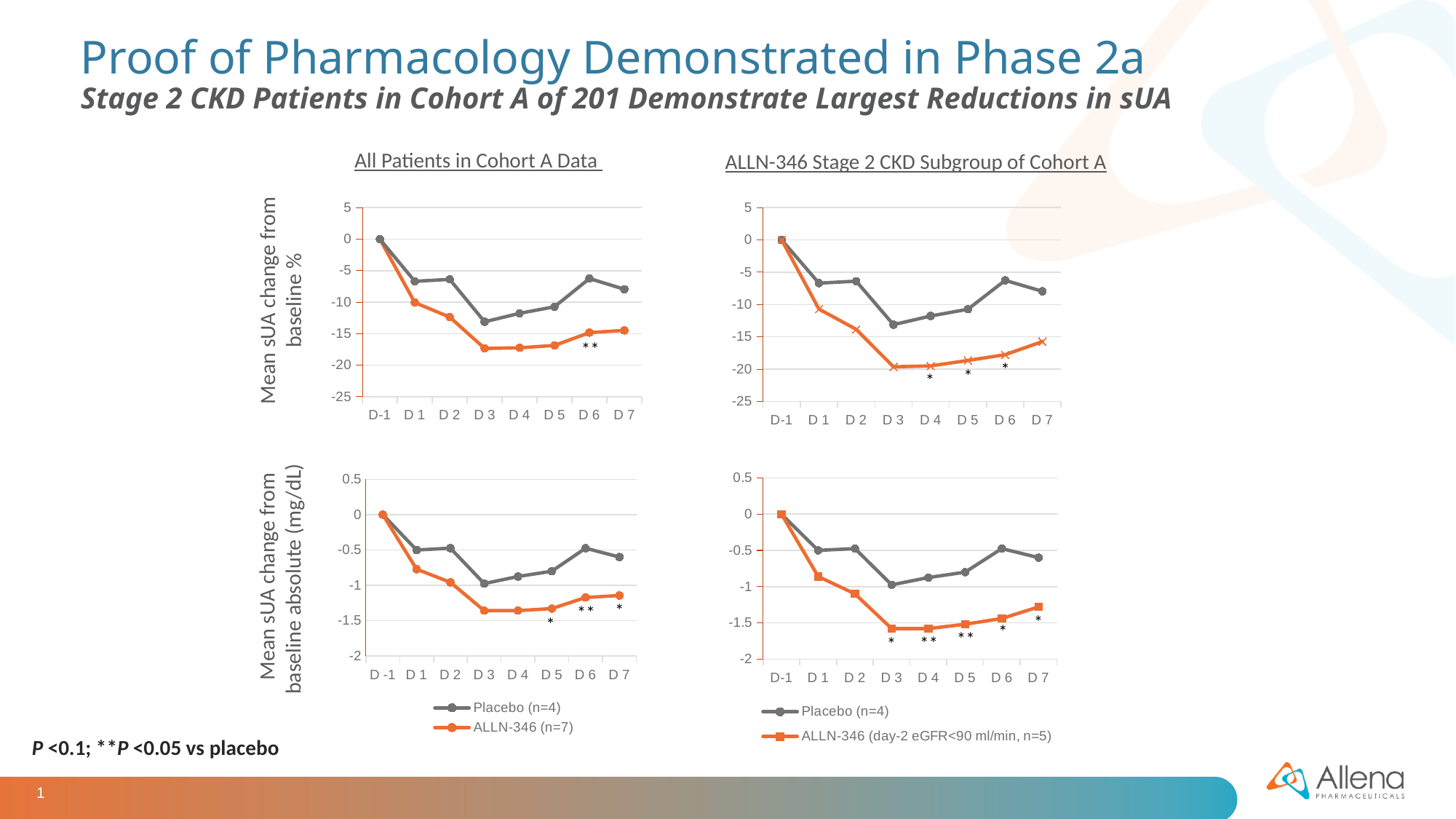
In the top-left chart (All Patients in Cohort A Data), at which time point is the Placebo series lowest? D 3 How many series does the legend under the bottom-left chart list? 2 In the top-left chart (All Patients in Cohort A Data), is the value for ALLN-346 at D 3 greater or less than -15? less In the top-right chart (ALLN-346 Stage 2 CKD Subgroup of Cohort A), is the value for ALLN-346 at D 3 greater or less than -15? less In the bottom-left chart, does the Placebo series rise or fall from D -1 to D 3? Fall In the top-right chart (ALLN-346 Stage 2 CKD Subgroup of Cohort A), is the value for Placebo at D 6 greater or less than -10? greater In the top-left chart (All Patients in Cohort A Data), how many time points are shown on the x axis? 8 What is the legend label of the orange series in the bottom-right chart? ALLN-346 (day-2 eGFR<90 ml/min, n=5) In the top-left chart (All Patients in Cohort A Data), which series has the larger value at D 3, Placebo or ALLN-346? Placebo What kind of chart is the top-left chart titled 'All Patients in Cohort A Data'? Line chart In the top-left chart (All Patients in Cohort A Data), what is the value for Placebo at D-1? 0